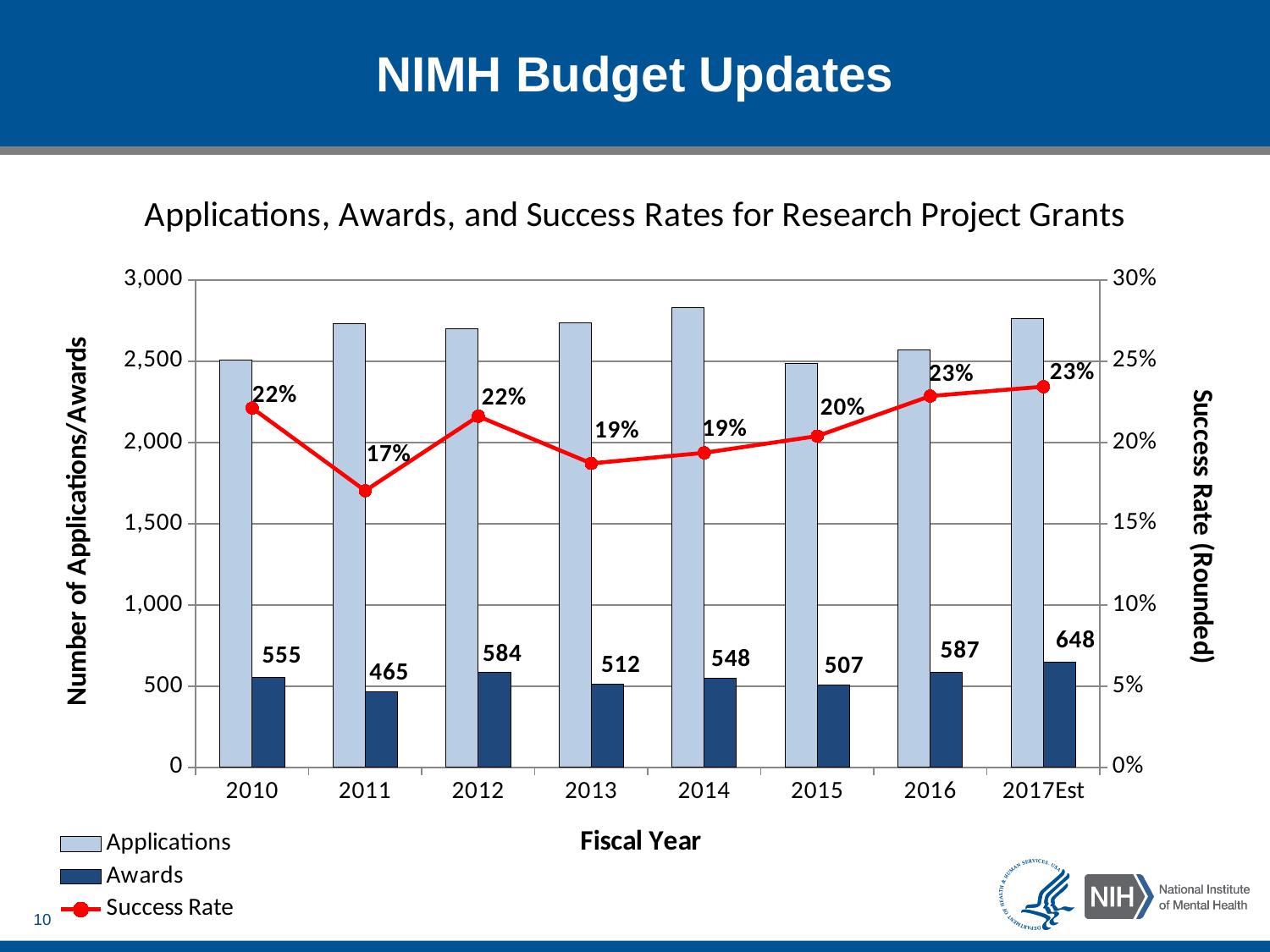
What is the number of Awards in fiscal year 2017Est? 648 Which fiscal year has the lowest Success Rate? 2011 Is the number of Applications in 2014 greater or less than 2,500? greater What is the Success Rate for fiscal year 2011? 17% How many fiscal years are shown on the x axis? 8 What is the title of the chart? Applications, Awards, and Success Rates for Research Project Grants Which is larger, the number of Awards in 2012 or in 2014? 2012 How many series does the legend list? 3 Which fiscal year has the highest number of Awards? 2017Est What is the difference in Awards between 2016 and 2015? 80 What kind of chart is used to show Applications and Awards? bar chart What is the number of Awards in fiscal year 2013? 512